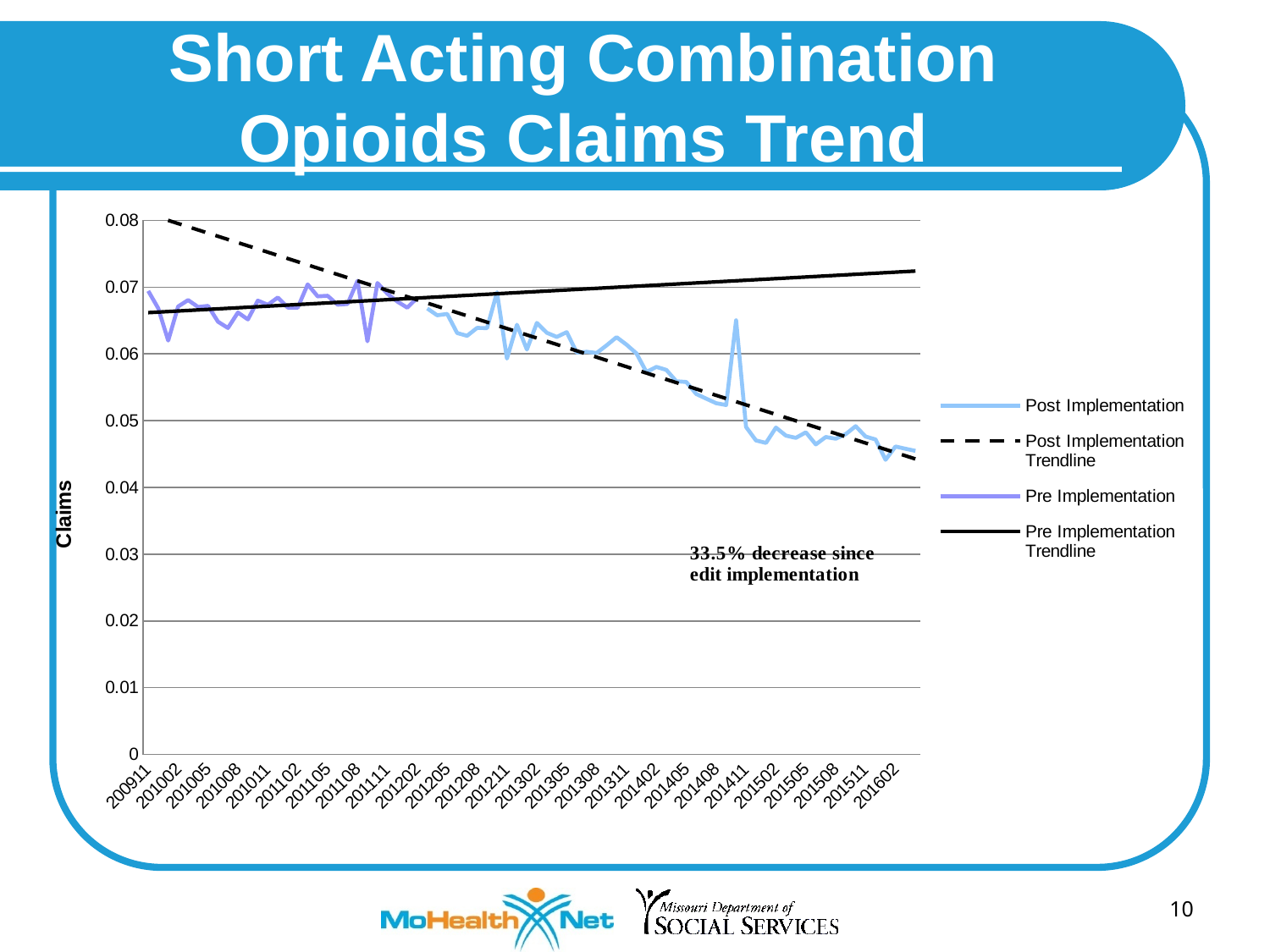
Is the Post Implementation value at 201411 greater or less than 0.06? less Is the Post Implementation value at 201602 greater or less than 0.05? less How many series does the legend list? 4 Does the Post Implementation Trendline rise or fall along the x axis? Fall What is the title of the chart on the slide? Short Acting Combination Opioids Claims Trend What kind of chart is shown on the slide? Line chart Which is larger: the Pre Implementation value at 200911 or the Post Implementation value at 201602? Pre Implementation value at 200911 What is the label on the y axis? Claims Does the Pre Implementation Trendline rise or fall along the x axis? Rise Is the Pre Implementation value at 200911 greater or less than 0.06? greater